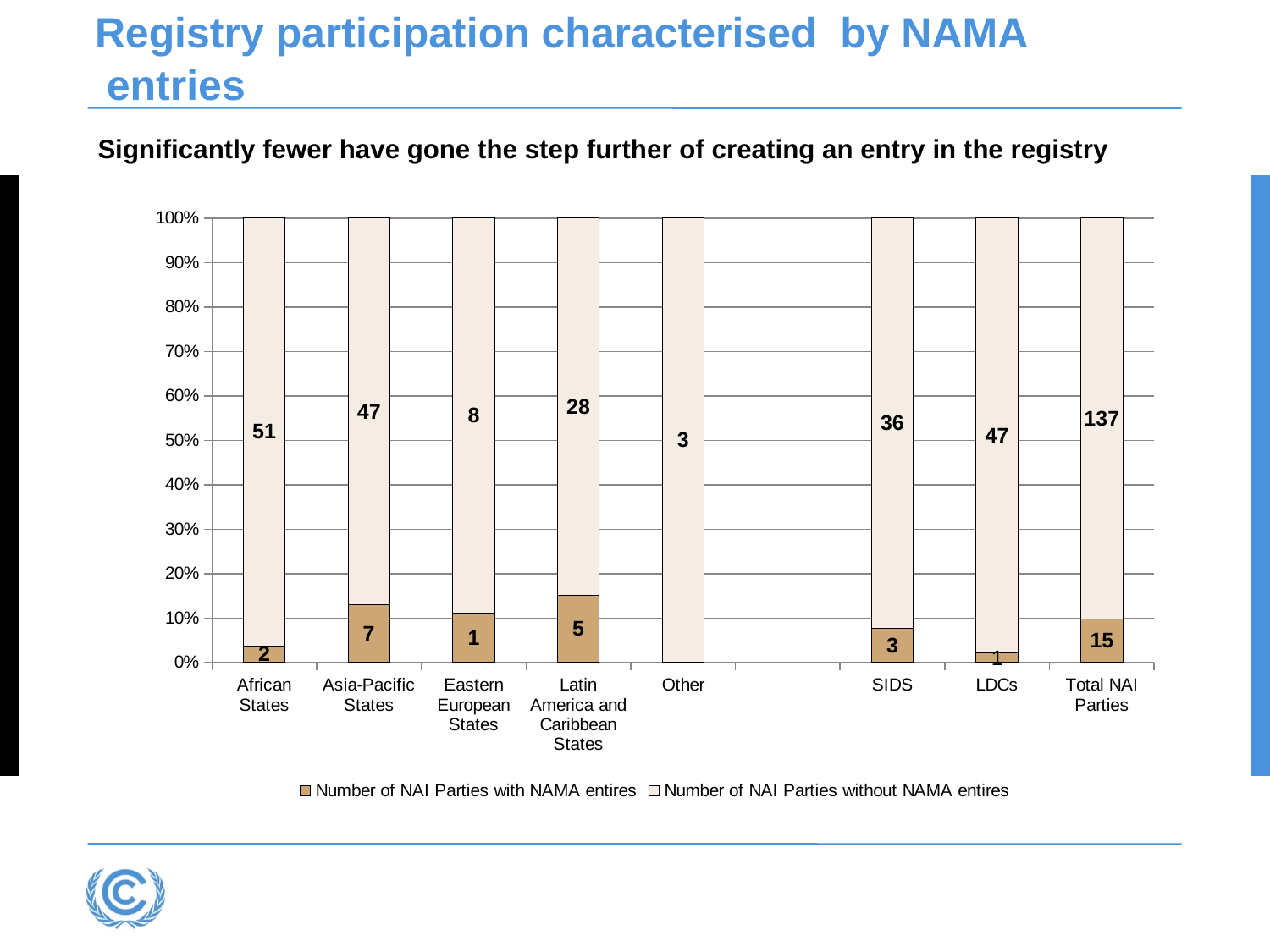
What is the number of NAI Parties without NAMA entries for Latin America and Caribbean States? 28 Excluding Total NAI Parties, which category has the highest number of NAI Parties with NAMA entries? Asia-Pacific States How many series does the legend list? 2 What is the difference between the number of NAI Parties without NAMA entries for African States and for SIDS? 15 How many labelled categories are shown on the x axis? 8 Is the share of NAI Parties with NAMA entries for African States greater or less than 10%? less How many NAI Parties with NAMA entries are shown for African States? 2 Is the share of NAI Parties with NAMA entries for Latin America and Caribbean States greater or less than 10%? greater Which is larger: the number of NAI Parties with NAMA entries for Asia-Pacific States or for Latin America and Caribbean States? Asia-Pacific States What is the combined number of NAI Parties with and without NAMA entries for LDCs? 48 Which category has the highest number of NAI Parties without NAMA entries? Total NAI Parties What is the number of NAI Parties with NAMA entries for Total NAI Parties? 15